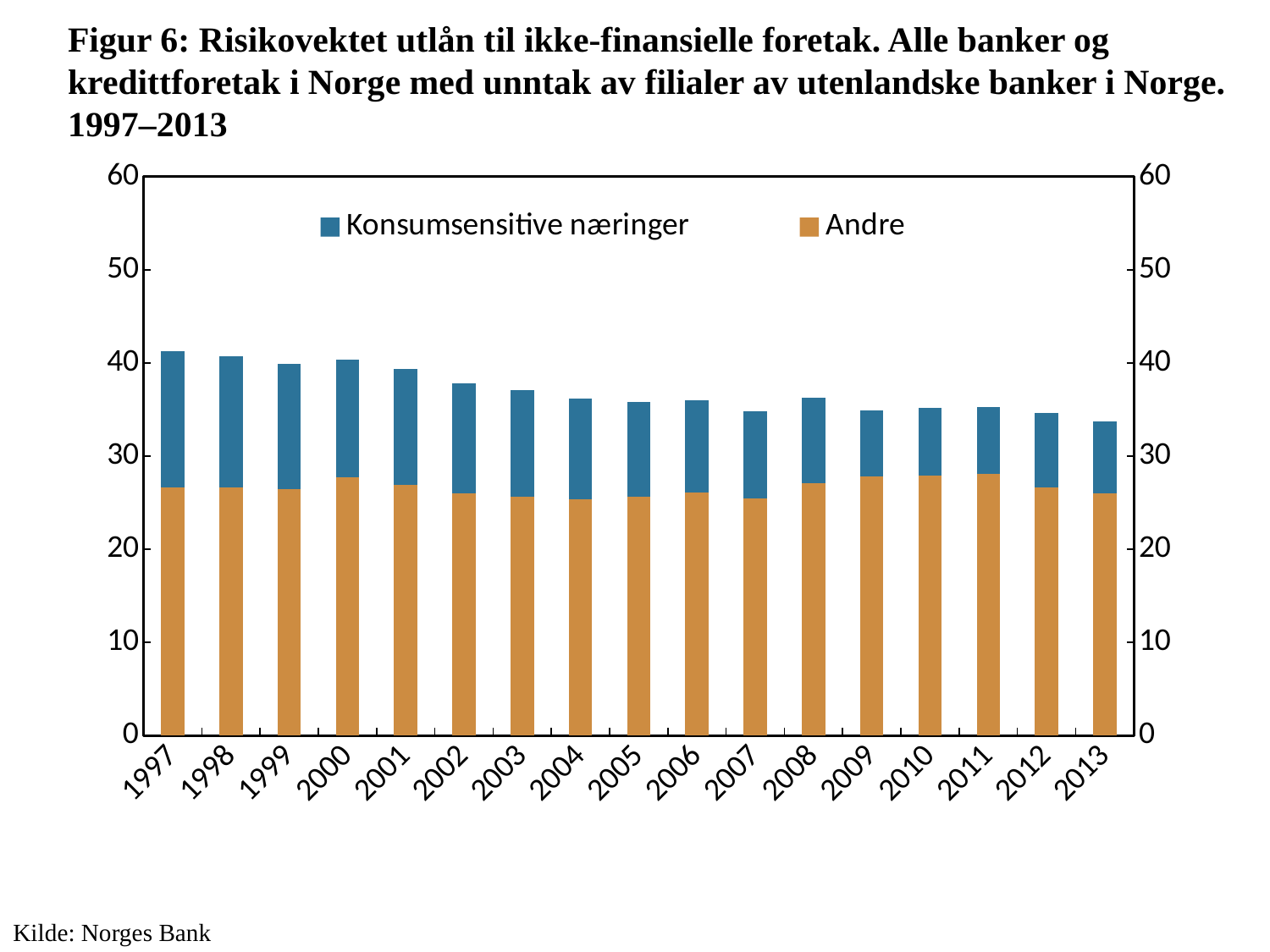
How many years are shown on the x axis? 17 Do the total bar heights generally rise or fall from 1997 to 2013? fall Is the value for Andre in 2010 greater or less than 30? less Which series is shown in blue? Konsumsensitive næringer What kind of chart is shown on the slide? stacked bar chart How many series does the legend list? 2 Is the total value of the bar for 2013 greater or less than 40? less Which year has the larger total bar, 1997 or 2013? 1997 Is the total value of the bar for 2008 greater or less than 30? greater Which series is shown in orange? Andre